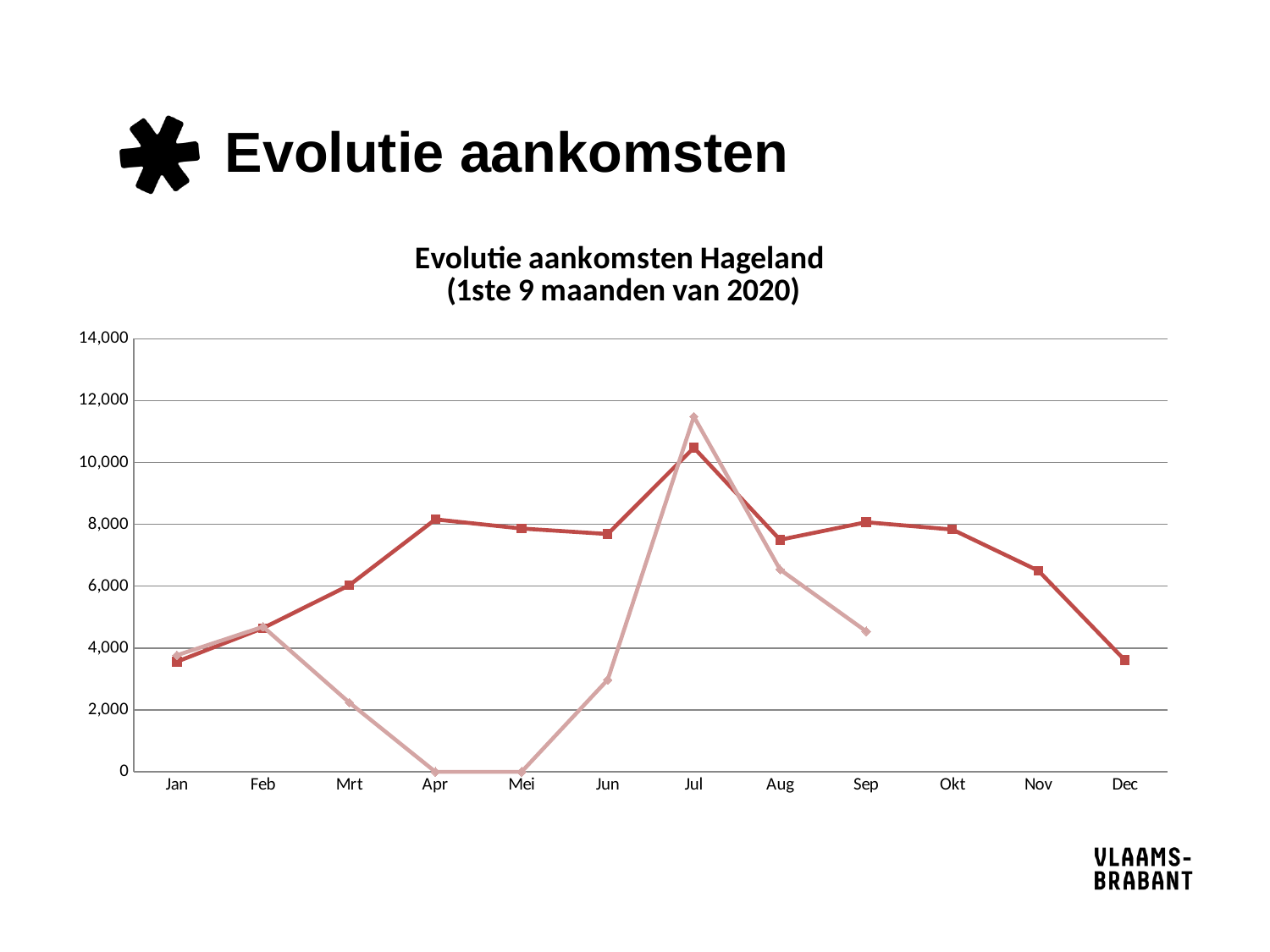
Is the value of the lighter pink line in Mrt greater or less than 4,000? less In which month does the lighter pink line reach its highest value? Jul What is the last month for which the lighter pink line has a data point? Sep What is the title of the chart? Evolutie aankomsten Hageland (1ste 9 maanden van 2020) Is the value of the darker red line in Apr greater or less than 6,000? greater In which month does the darker red line reach its highest value? Jul Does the darker red line rise or fall from Sep to Dec? fall Is the value of the darker red line in Jul greater or less than 10,000? greater For the lighter pink line, which is larger: the value in Feb or the value in Mrt? Feb What kind of chart is shown on the slide? line chart How many months are labelled on the x axis of the chart? 12 How many lines are plotted on the chart? 2